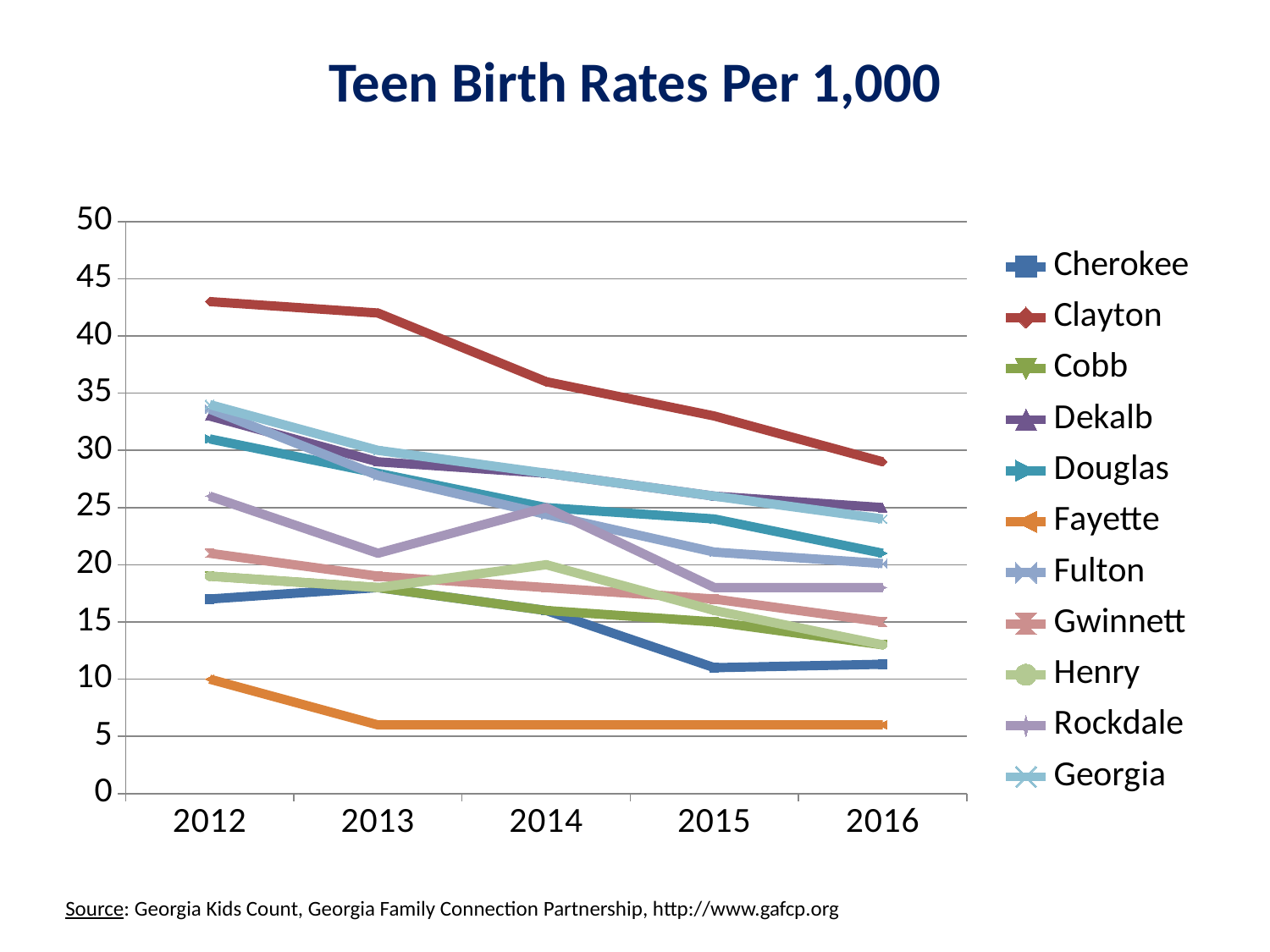
Which county had the highest teen birth rate in 2012? Clayton Is the value for Cherokee in 2015 greater or less than 15? less Is the value for Clayton in 2012 greater or less than 40? greater In 2016, which is larger, the value for Clayton or the value for Fayette? Clayton Does the Clayton line rise or fall from 2012 to 2016? fall Which county had the lowest teen birth rate in 2016? Fayette What kind of chart is shown on the slide? line chart What is the title of the chart? Teen Birth Rates Per 1,000 How many series does the legend list? 11 How many years are shown on the x axis? 5 Is the value for Fayette in 2016 greater or less than 10? less What is the value for Fayette in 2012? 10